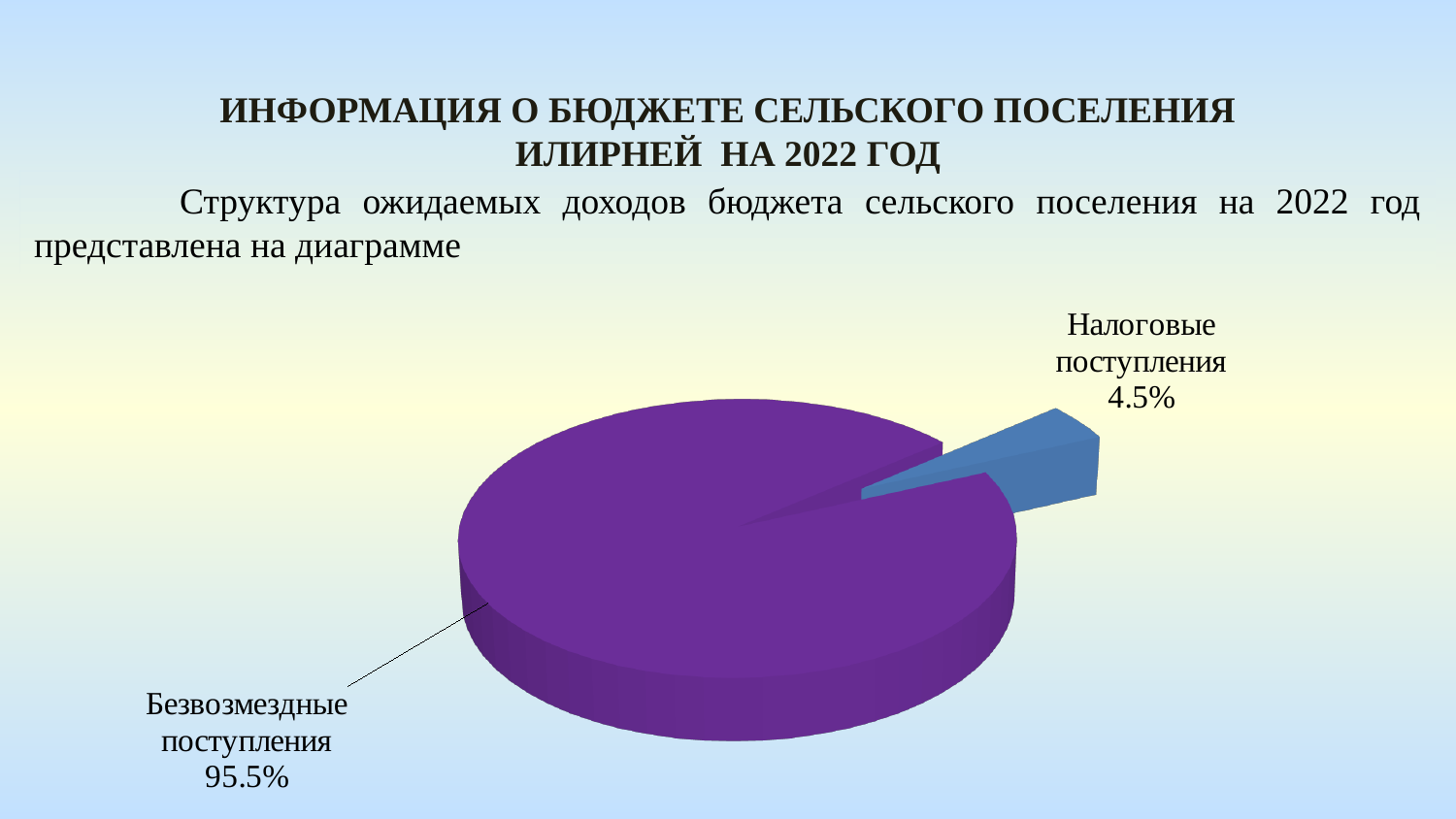
What colour is the slice for "Безвозмездные поступления"? Purple What share of the pie is labelled "Безвозмездные поступления"? 95.5% What is the difference in percentage points between "Безвозмездные поступления" and "Налоговые поступления"? 91 percentage points What kind of chart is shown on the slide? Pie chart Is the share for "Налоговые поступления" greater or less than 10%? less How many slices does the pie chart have? 2 Which category has the smallest share of the pie? Налоговые поступления What share of the pie is labelled "Налоговые поступления"? 4.5% Is the share for "Безвозмездные поступления" greater or less than 90%? greater Which category has the largest share of the pie? Безвозмездные поступления What colour is the slice for "Налоговые поступления"? Blue Which is larger: the share for "Налоговые поступления" or the share for "Безвозмездные поступления"? Безвозмездные поступления